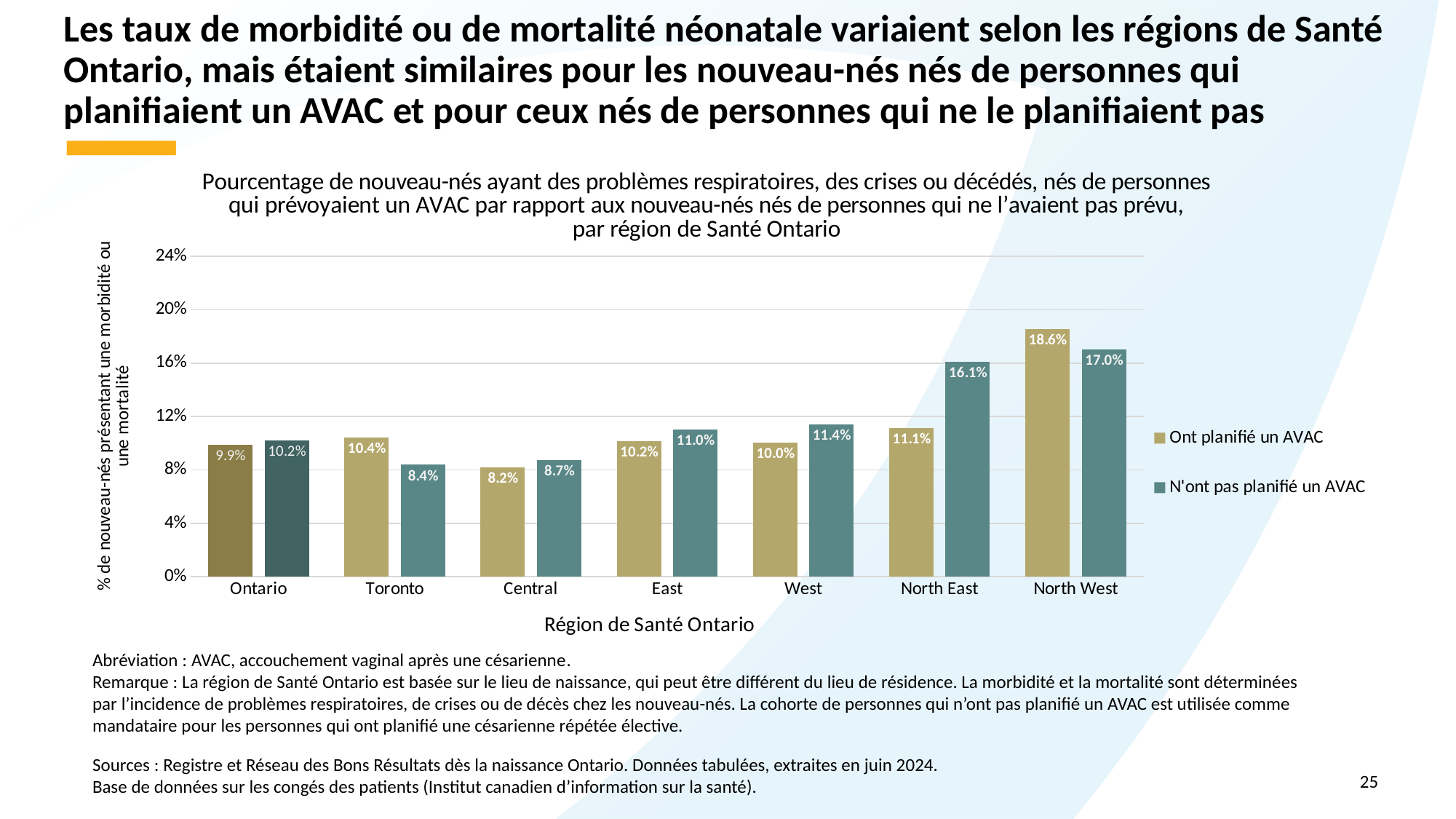
How many series does the legend list? 2 What is the difference between the 'Ont planifié un AVAC' and 'N'ont pas planifié un AVAC' values for North East? 5.0% What is the value for North East in the 'N'ont pas planifié un AVAC' series? 16.1% What is the x-axis title of the chart? Région de Santé Ontario Is the 'Ont planifié un AVAC' value for North West greater or less than 16%? greater Which region has the lowest value in the 'N'ont pas planifié un AVAC' series? Toronto What is the value for Ontario in the 'N'ont pas planifié un AVAC' series? 10.2% Which is larger for Central: the 'Ont planifié un AVAC' value or the 'N'ont pas planifié un AVAC' value? N'ont pas planifié un AVAC How many regions are shown on the x axis? 7 What is the value for Toronto in the 'Ont planifié un AVAC' series? 10.4% Which region has the highest value in the 'Ont planifié un AVAC' series? North West What kind of chart is shown on the slide? Bar chart